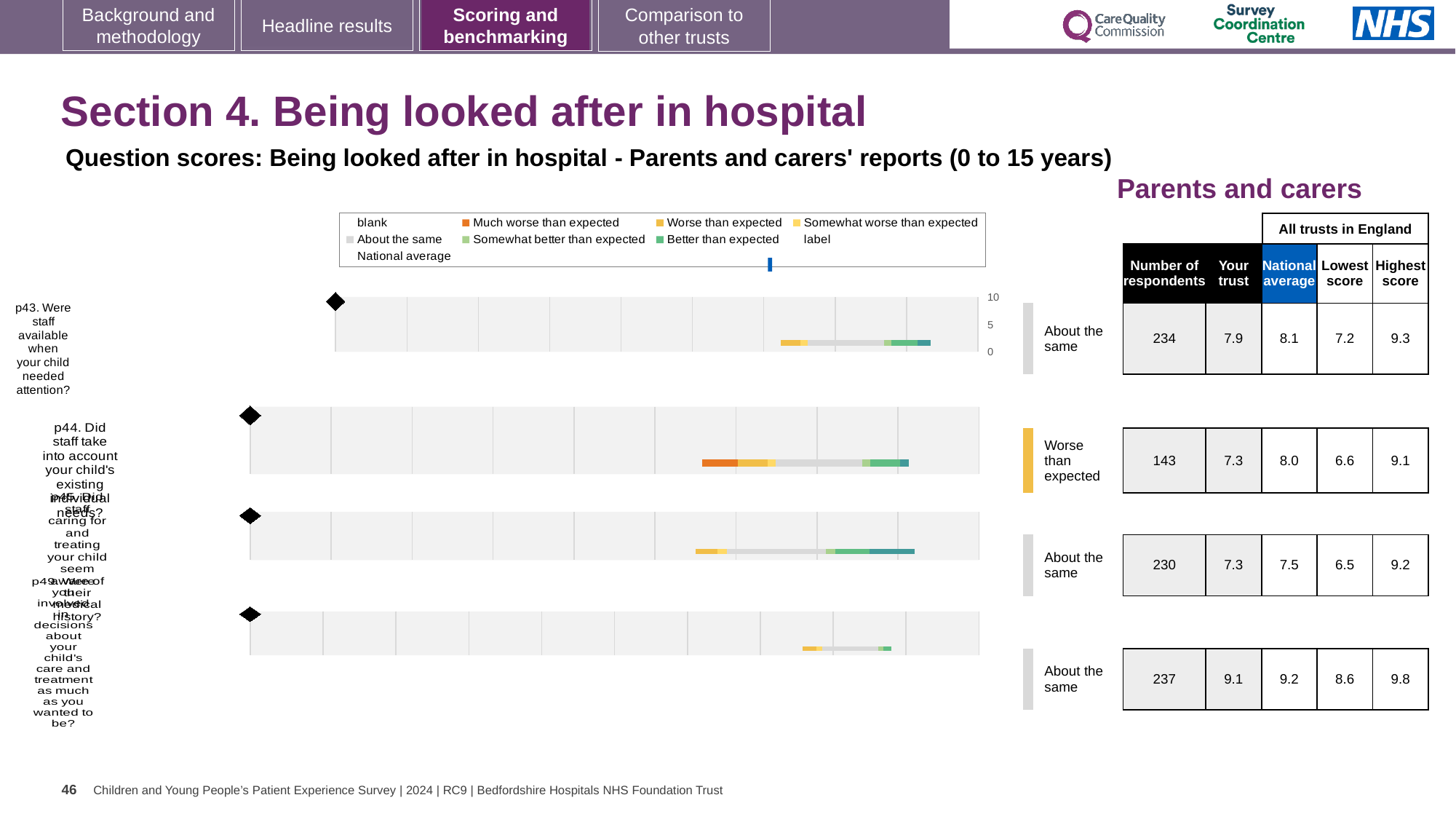
How many questions are shown in the chart and table on this slide? 4 What colour does the legend use for 'Much worse than expected'? orange How many of the questions are rated 'Worse than expected'? 1 What is the highest score among all trusts in England for p43? 9.3 For the question rated 'Worse than expected', how many respondents are there? 143 What is the 'Your trust' score for p43 (Were staff available when your child needed attention?)? 7.9 For p43, what is the difference between the national average and the 'Your trust' score? 0.2 What is the national average score for p43 (Were staff available when your child needed attention?)? 8.1 What is the highest 'Your trust' score shown in the table? 9.1 For the question rated 'Worse than expected', what is the 'Your trust' score? 7.3 For p43, is the 'Your trust' score higher or lower than the national average? lower In the table, how many respondents answered p43 (Were staff available when your child needed attention?)? 234